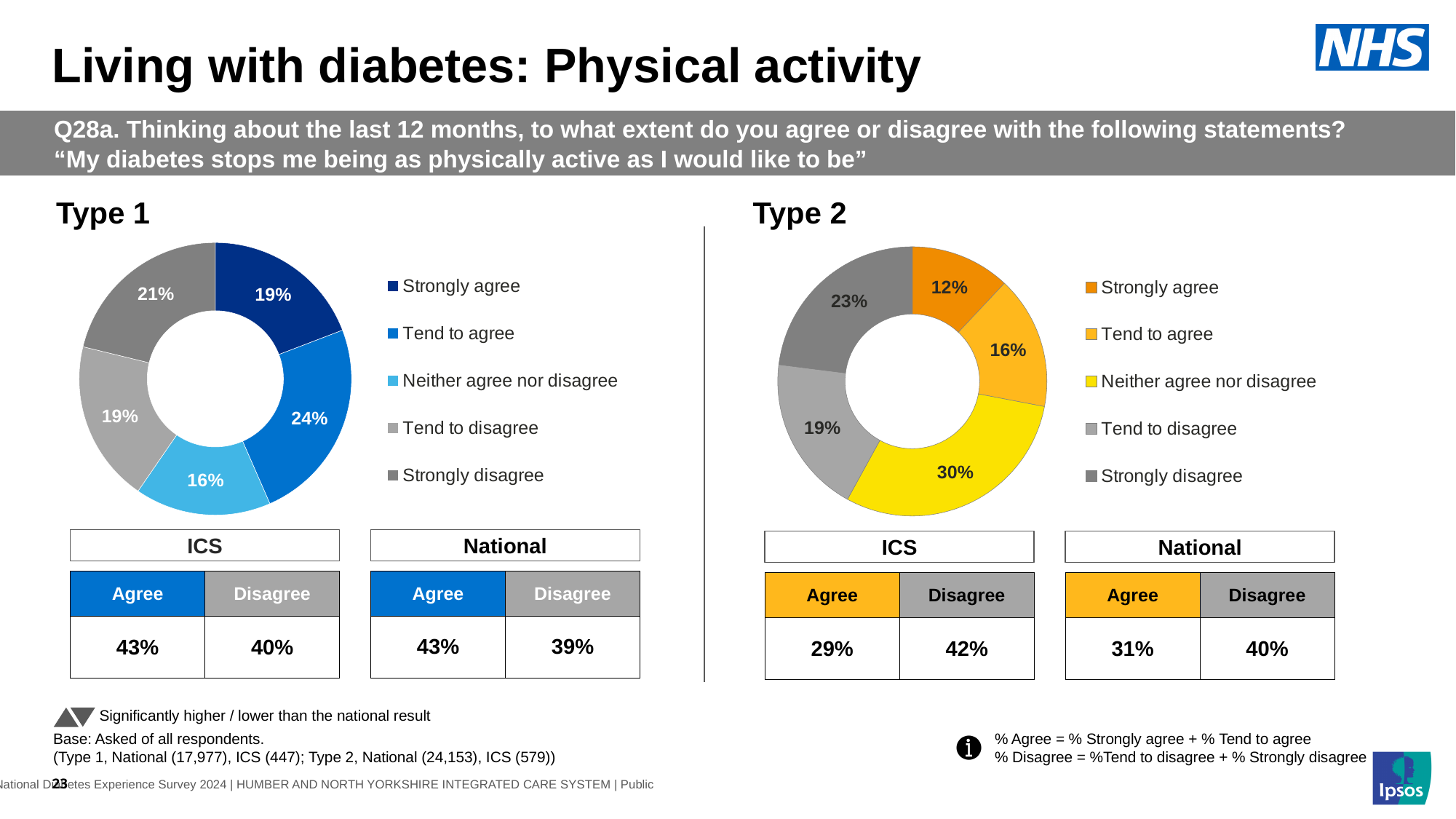
In the Type 1 chart, what is the difference between the 'Tend to agree' and 'Neither agree nor disagree' percentages? 8 percentage points In the Type 2 chart, which response category has the smallest share? Strongly agree In the Type 2 chart, what percentage of respondents said 'Neither agree nor disagree'? 30% In the Type 2 chart, what percentage of respondents said 'Strongly agree'? 12% What type of chart is used for the Type 1 and Type 2 results? Donut (pie) chart In the Type 1 chart, what percentage of respondents said 'Tend to agree'? 24% How many response categories does the legend of the Type 1 chart list? 5 In the Type 1 chart, what percentage of respondents said 'Strongly disagree'? 21% In the Type 2 chart, which response category has the largest share? Neither agree nor disagree In the Type 2 chart, what colour is the 'Neither agree nor disagree' segment? Yellow In the Type 1 chart, which response category has the smallest share? Neither agree nor disagree In the Type 2 chart, which is larger: 'Strongly disagree' or 'Tend to disagree'? Strongly disagree